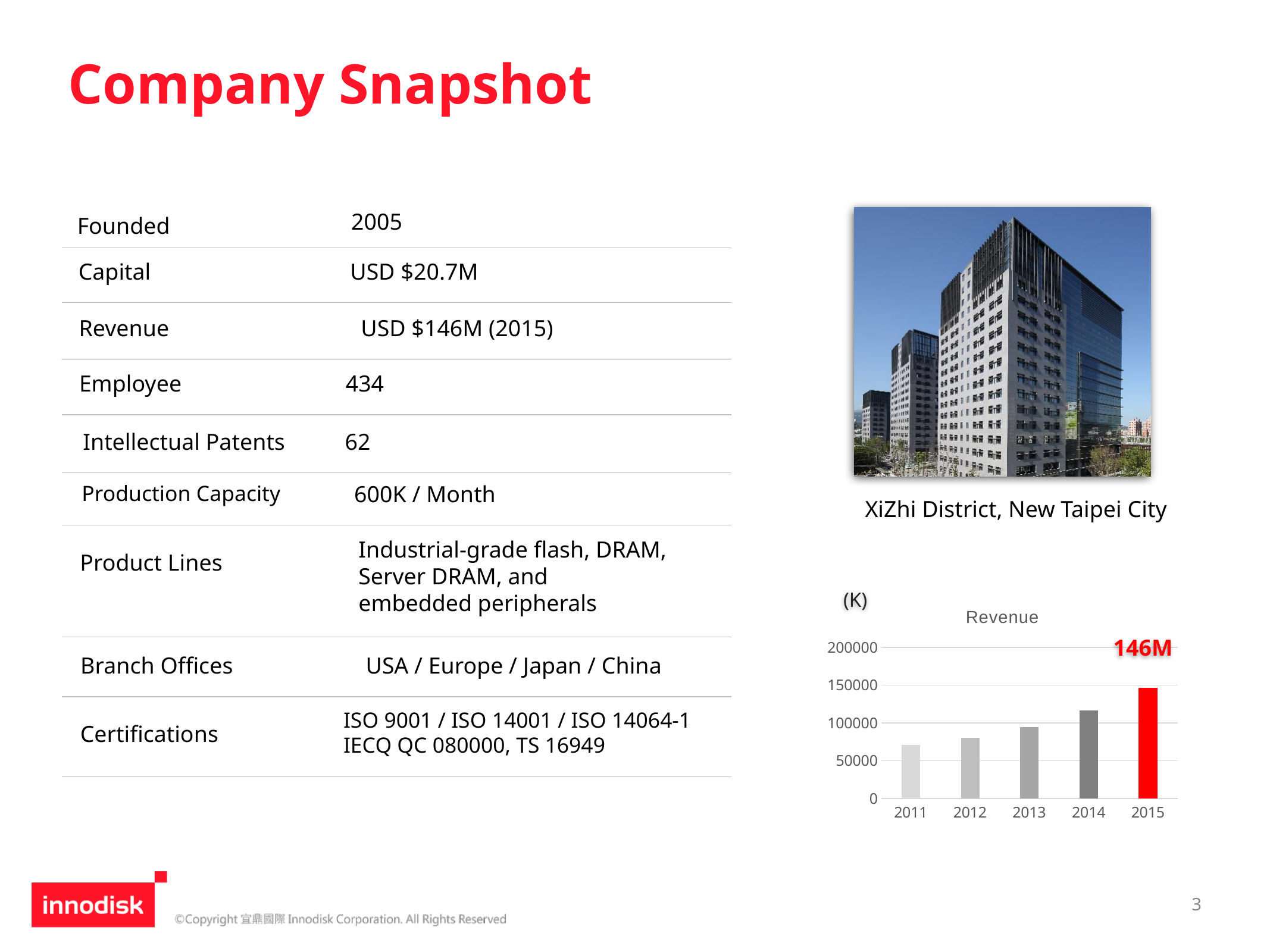
How many years are shown on the x axis of the Revenue chart? 5 What kind of chart is the Revenue chart? bar chart Is the revenue for 2014 greater or less than 100000? greater What is the title of the bar chart? Revenue Is the revenue for 2012 greater or less than 50000? greater What colour is the 2015 bar in the Revenue chart? red Do the revenue values rise or fall from 2011 to 2015? rise Which year has the larger revenue, 2012 or 2014? 2014 What value is labelled on the 2015 bar in the Revenue chart? 146M Is the revenue for 2011 greater or less than 100000? less Which year has the highest revenue in the Revenue chart? 2015 Which year has the lowest revenue in the Revenue chart? 2011